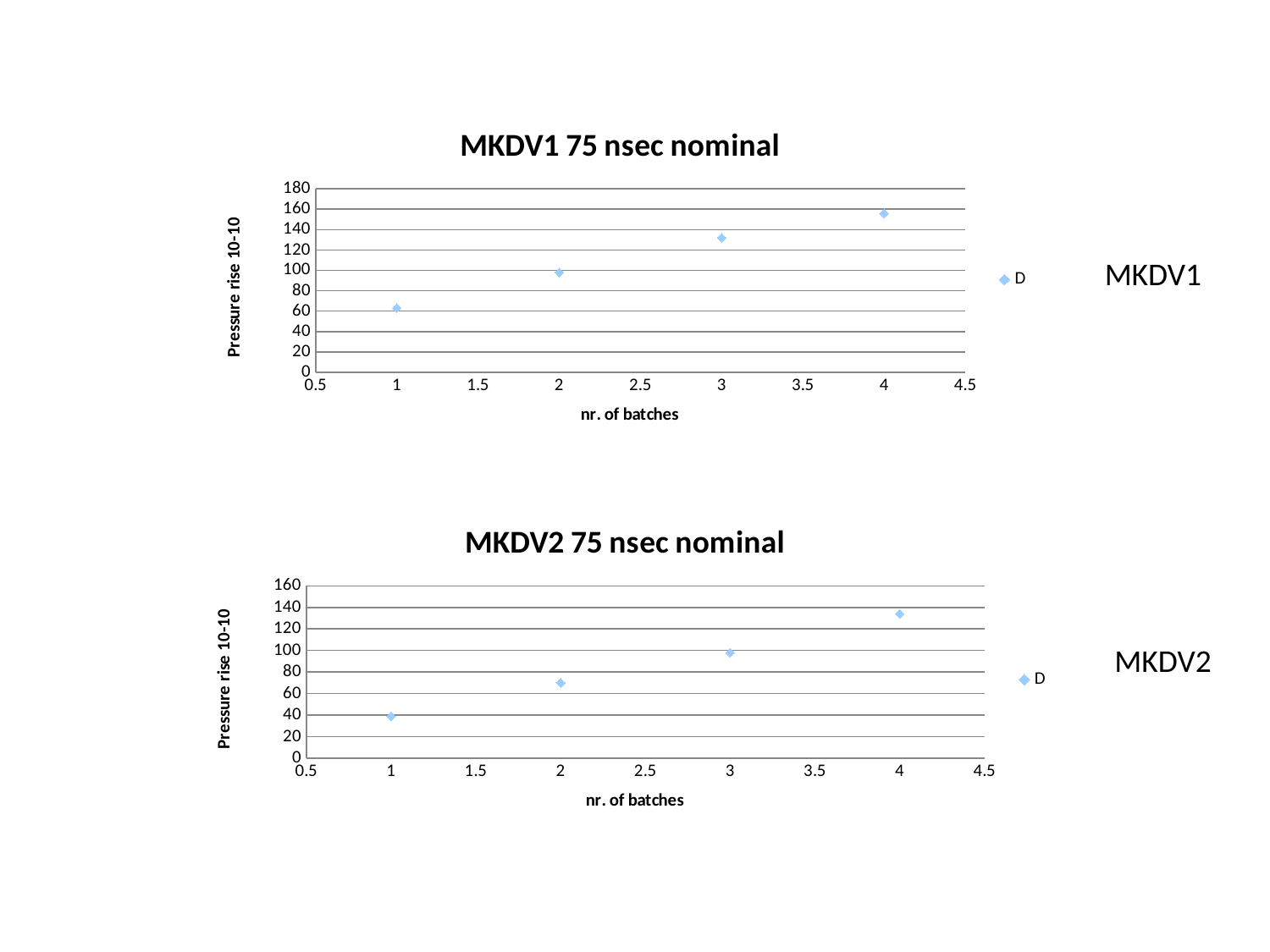
In the MKDV1 75 nsec nominal chart, at which number of batches is the pressure rise highest? 4 In the MKDV2 75 nsec nominal chart, is the value at 4 batches greater or less than 120? greater In the MKDV2 75 nsec nominal chart, what is the label on the x axis? nr. of batches In the MKDV1 75 nsec nominal chart, how many data points are plotted? 4 In the MKDV1 75 nsec nominal chart, what kind of chart is shown? scatter chart In the MKDV1 75 nsec nominal chart, is the value at 4 batches greater or less than 140? greater In the MKDV2 75 nsec nominal chart, do the values rise or fall as the number of batches increases? rise In the MKDV1 75 nsec nominal chart, do the values rise or fall as the number of batches increases? rise In the MKDV2 75 nsec nominal chart, how many series does the legend list? 1 In the MKDV2 75 nsec nominal chart, is the value at 1 batch greater or less than 60? less In the MKDV2 75 nsec nominal chart, at which number of batches is the pressure rise lowest? 1